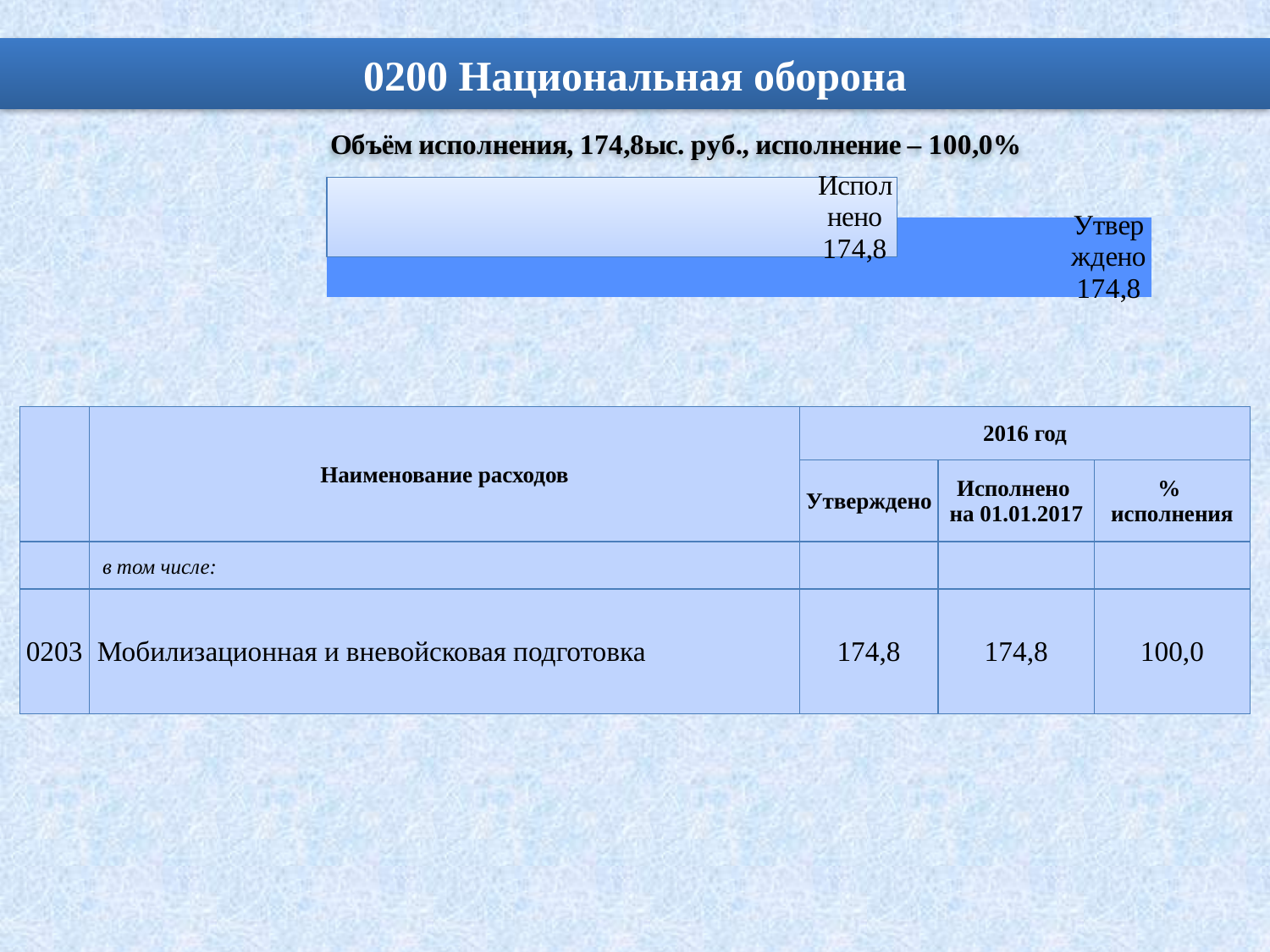
Are the bars in the chart horizontal or vertical? horizontal Is the value for "Утверждено" greater or less than 200? less What value is labelled on the bar "Утверждено"? 174,8 What is the difference between the values of the "Утверждено" and "Исполнено" bars? 0,0 What kind of chart is shown on the slide? bar chart Which bar in the chart is drawn in the darker blue colour? Утверждено How many bars does the chart show? 2 Is the value for "Исполнено" greater or less than 100? greater What value is labelled on the bar "Исполнено"? 174,8